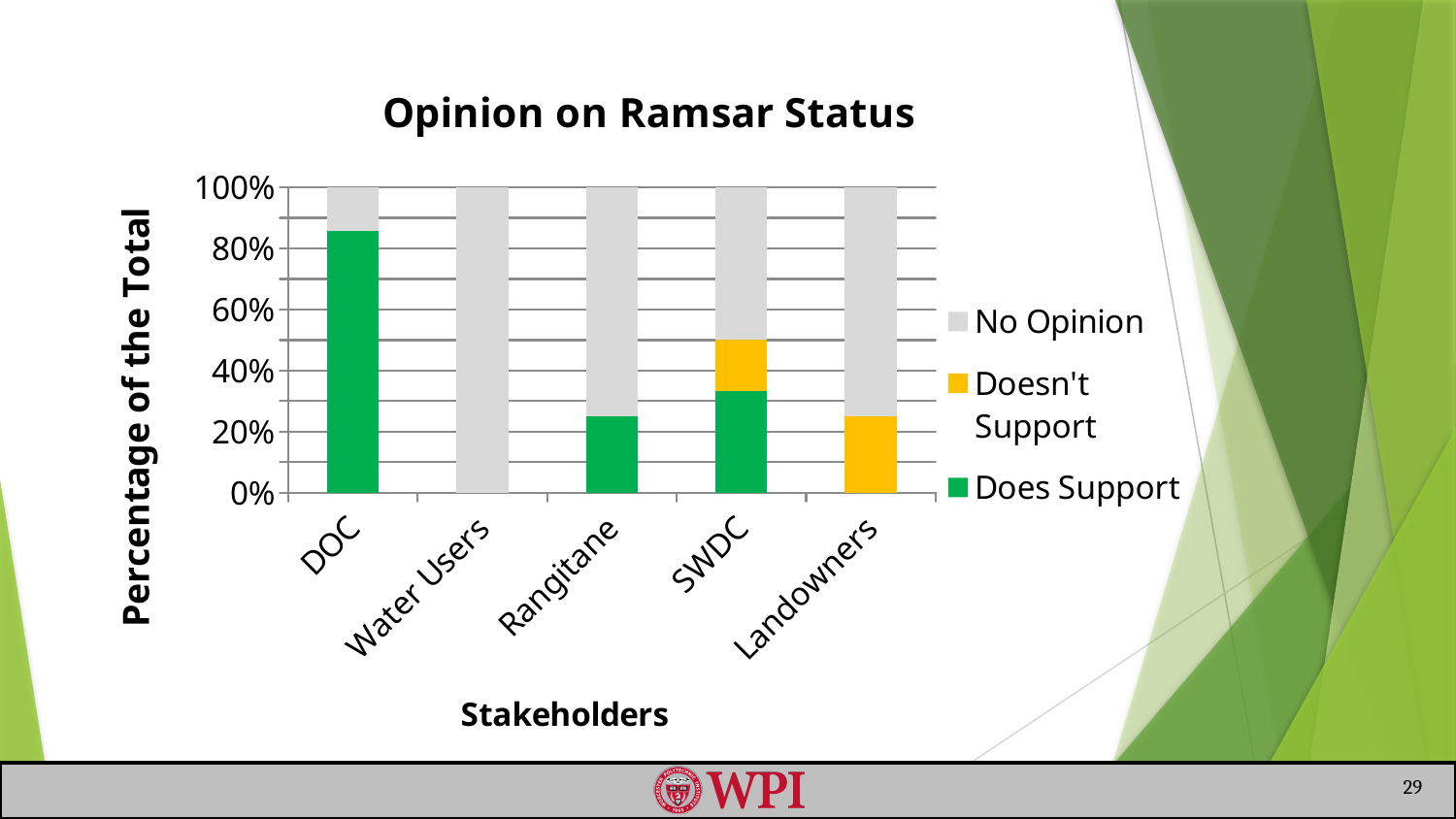
Which has a larger Does Support share, DOC or Rangitane? DOC What percentage of Water Users have No Opinion? 100% How many series does the legend list? 3 Is the Does Support value for Rangitane greater or less than 40%? less Is the Does Support value for SWDC greater or less than 20%? greater How many stakeholder categories are shown on the x axis? 5 What is the title of the chart? Opinion on Ramsar Status What kind of chart is shown on the slide? Stacked bar chart Is the Does Support value for DOC greater or less than 80%? greater Which colour represents the Doesn't Support series in the legend? Yellow Which stakeholder has the largest Does Support share? DOC